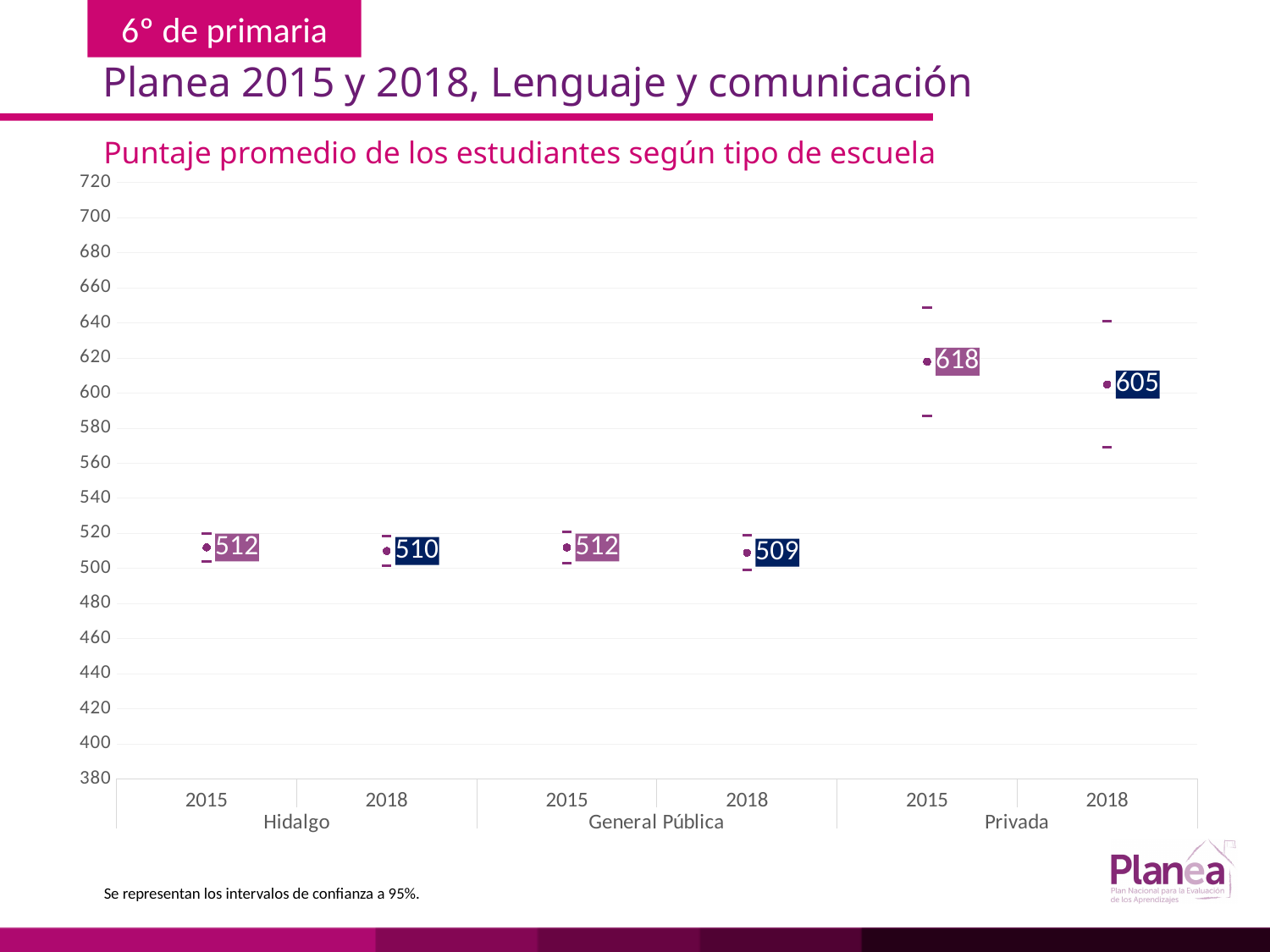
What is the average score for Privada in 2015? 618 Which is larger, the Hidalgo 2018 score or the General Pública 2018 score? Hidalgo 2018 How many data points are plotted on the chart? 6 What is the average score for Hidalgo in 2018? 510 Which school type and year has the highest average score? Privada 2015 Which school type and year has the lowest average score? General Pública 2018 What is the average score for General Pública in 2018? 509 What is the title of the chart? Puntaje promedio de los estudiantes según tipo de escuela What is the difference between the Privada scores in 2015 and 2018? 13 What is the difference between the Privada 2018 score and the Hidalgo 2018 score? 95 What is the average score for Hidalgo in 2015? 512 What is the average score for Privada in 2018? 605